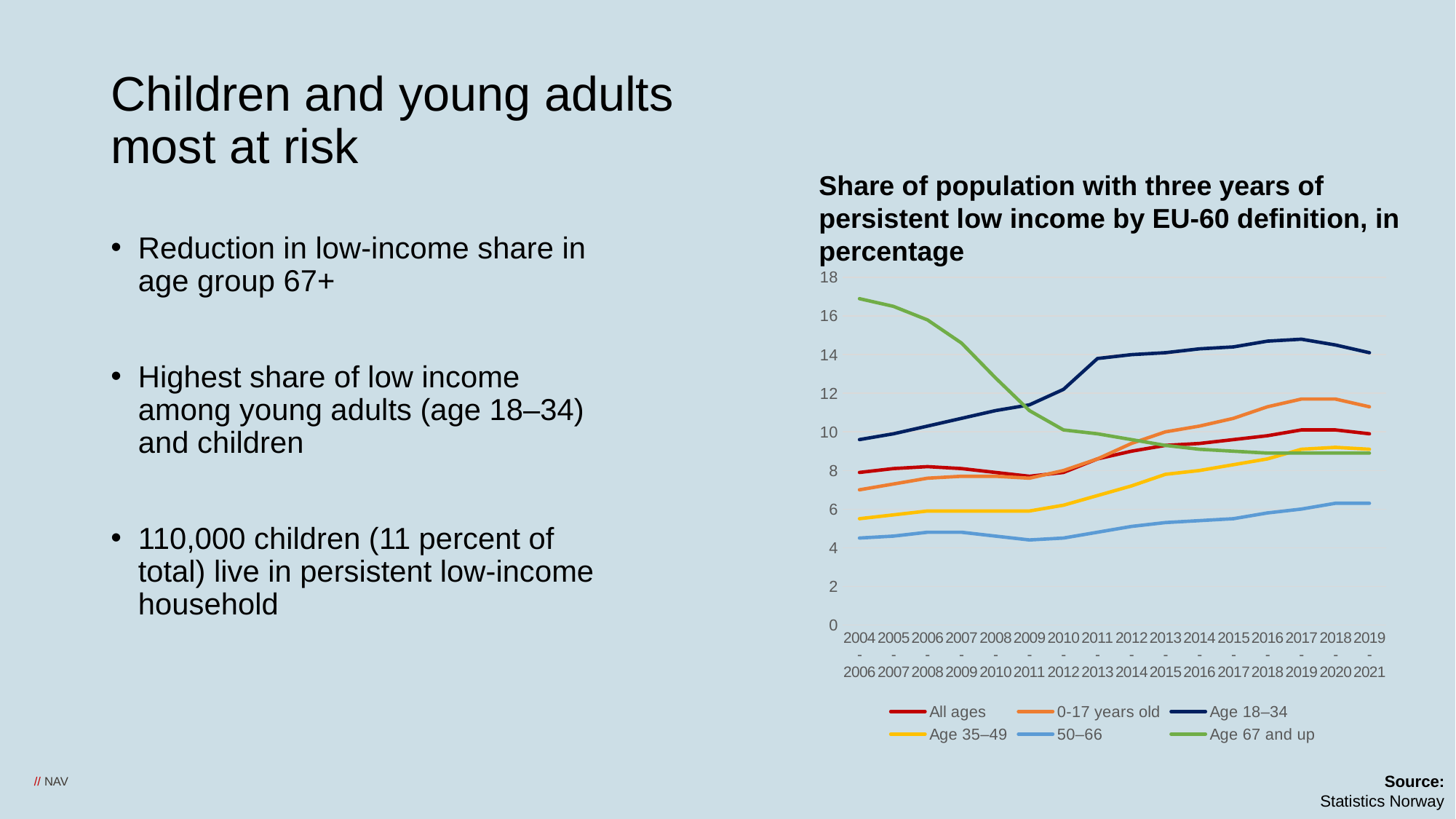
What is the title of the chart? Share of population with three years of persistent low income by EU-60 definition, in percentage What kind of chart is shown on the slide? Line chart How many three-year periods are shown along the x axis of the chart? 16 How many series does the chart's legend list? 6 Is the value for 50–66 in 2004-2006 greater or less than 6? less Does the share for Age 67 and up rise or fall from 2004-2006 to 2019-2021? Fall Which age group has the lowest share of persistent low income in the 2019-2021 period? 50–66 Is the value for Age 67 and up in 2004-2006 greater or less than 16? greater In the 2019-2021 period, which is larger: the share for 0-17 years old or the share for All ages? 0-17 years old Which age group has the highest share of persistent low income in the 2019-2021 period? Age 18–34 Does the share for Age 18–34 rise or fall overall from 2004-2006 to 2019-2021? Rise Which age group has the highest share of persistent low income in the 2004-2006 period? Age 67 and up